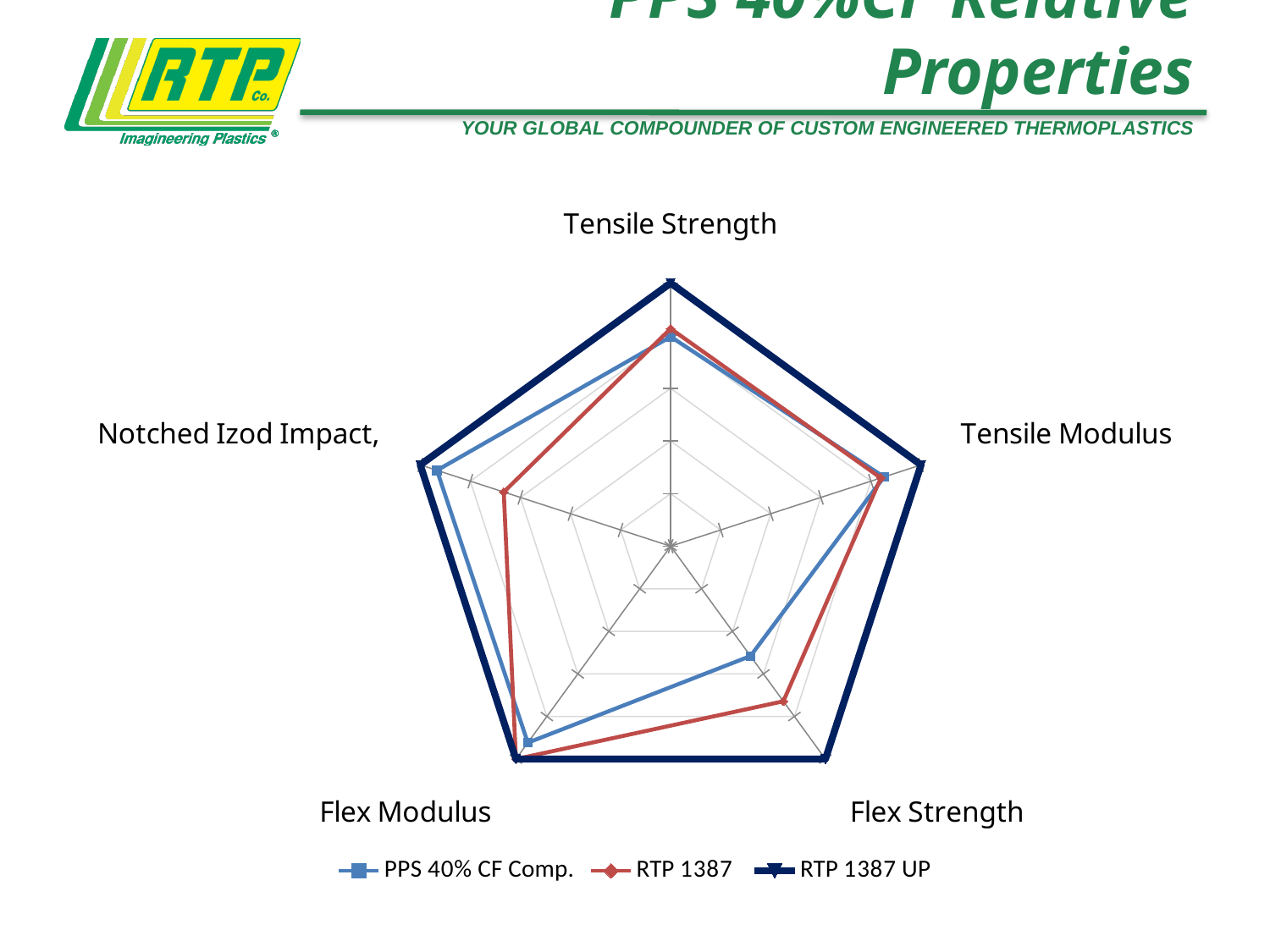
For Notched Izod Impact, which is larger: PPS 40% CF Comp. or RTP 1387? PPS 40% CF Comp. Which series has the highest value on every axis of the radar chart? RTP 1387 UP On which axis does the PPS 40% CF Comp. series have its lowest value? Flex Strength How many property axes (categories) does the radar chart have? 5 Which series is drawn in light blue with square markers on the radar chart? PPS 40% CF Comp. For Flex Modulus, which is larger: RTP 1387 UP or PPS 40% CF Comp.? RTP 1387 UP What kind of chart is shown on the slide? Radar chart For Flex Strength, which is larger: PPS 40% CF Comp. or RTP 1387? RTP 1387 Which series is drawn in red on the radar chart? RTP 1387 On which axis does the RTP 1387 series have its lowest value? Notched Izod Impact How many series does the legend of the radar chart list? 3